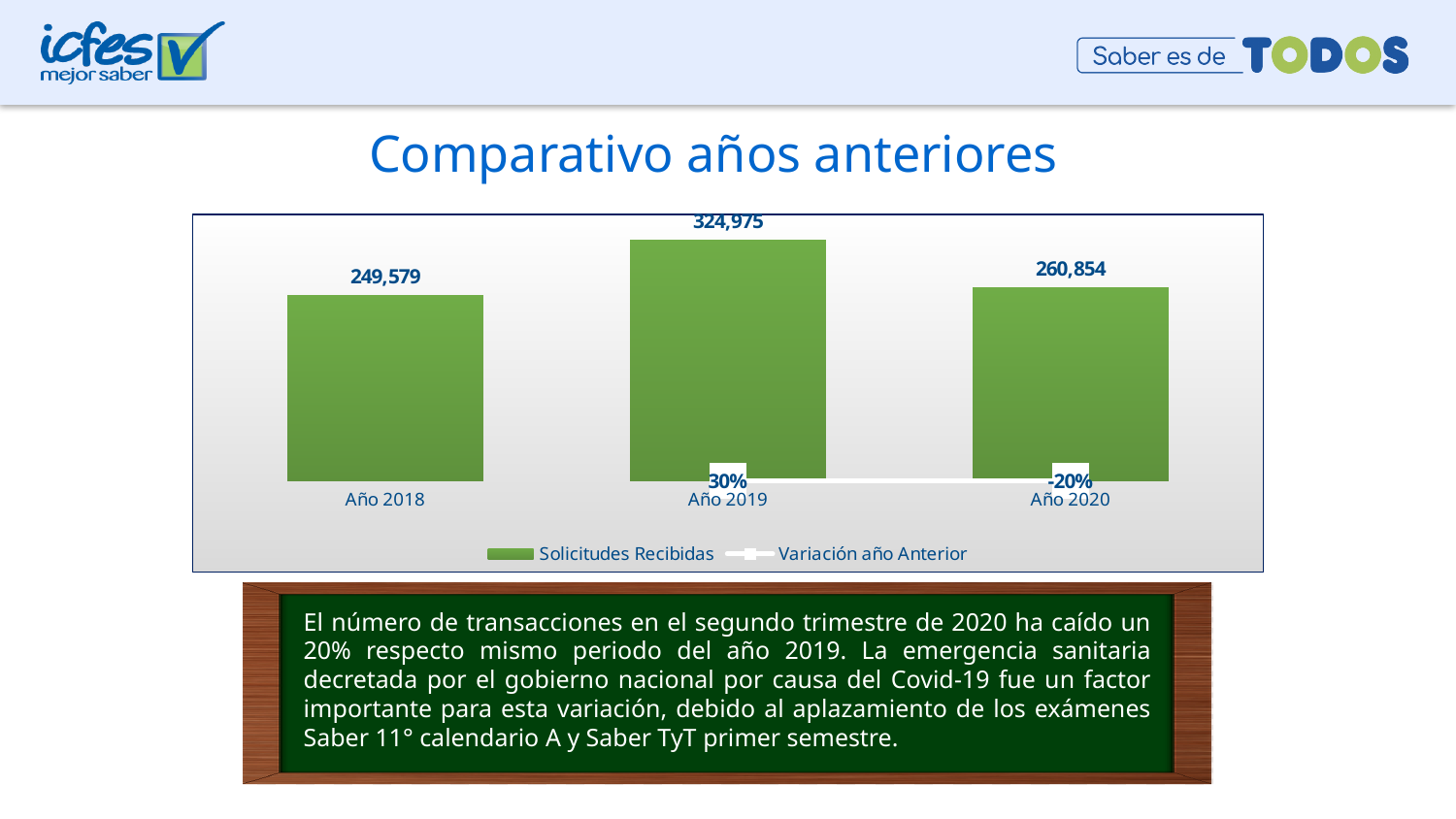
How many years are shown on the x axis of the chart? 3 Which is larger, Solicitudes Recibidas for Año 2018 or for Año 2020? Año 2020 Which year has the highest number of Solicitudes Recibidas? Año 2019 What is the Variación año Anterior value shown for Año 2020? -20% What is the difference in Solicitudes Recibidas between Año 2019 and Año 2020? 64,121 What is the value of Solicitudes Recibidas for Año 2018? 249,579 What is the title of the chart on the slide? Comparativo años anteriores What is the value of Solicitudes Recibidas for Año 2020? 260,854 What is the Variación año Anterior value shown for Año 2019? 30% How many series does the chart legend list? 2 What is the value of Solicitudes Recibidas for Año 2019? 324,975 Which year has the lowest number of Solicitudes Recibidas? Año 2018